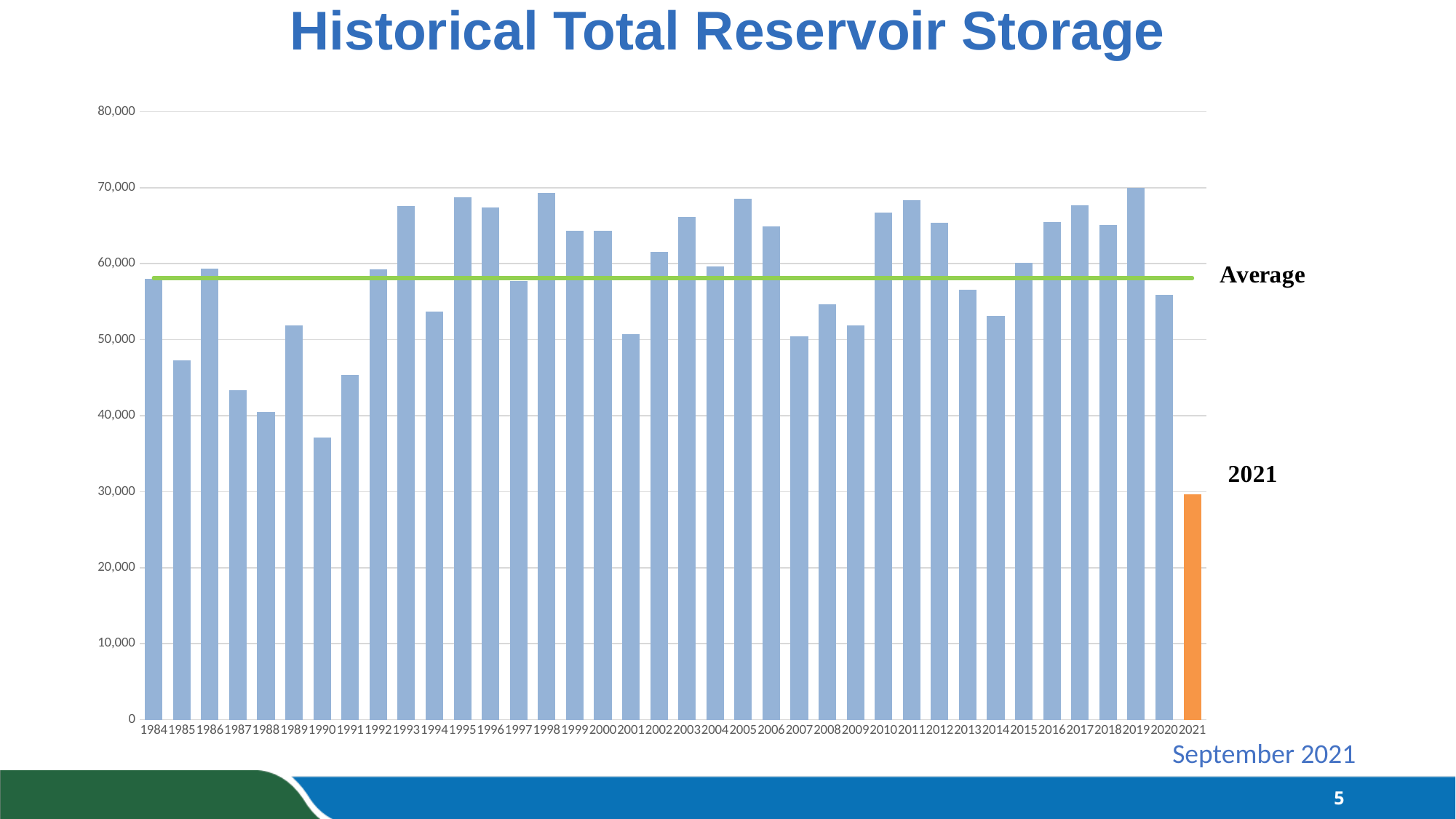
Is the value for 1993 greater or less than 60,000? greater What does the green horizontal line across the chart represent? Average Which year has the larger value, 1990 or 1991? 1991 Is the value for 2021 greater or less than 40,000? less How many years (bars) are plotted on the chart? 38 What is the title of the chart? Historical Total Reservoir Storage Is the value for 1985 greater or less than 50,000? less Which year has the lowest total reservoir storage? 2021 What kind of chart is shown on the slide? bar chart Which year has the larger value, 2020 or 2021? 2020 Is the value for 2021 above or below the Average line? below